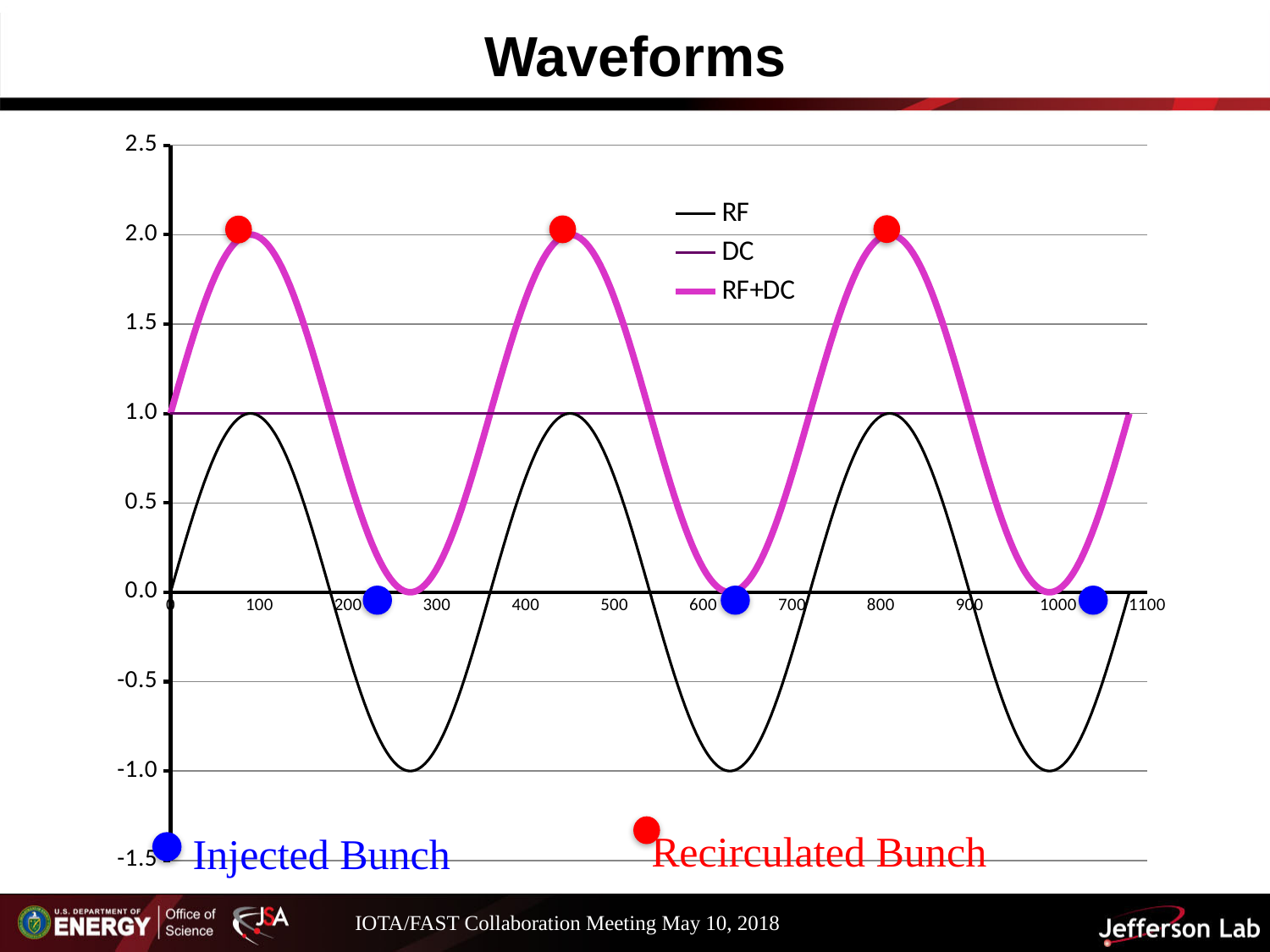
What is the lowest value reached by the RF series? -1.0 What is the peak value reached by the RF+DC series? 2.0 At x = 800, which series has the larger value, RF or RF+DC? RF+DC What kind of chart is shown on the slide? line chart What are the series names listed in the legend? RF, DC, RF+DC How many series does the legend list? 3 What constant value does the DC series hold across the x axis? 1.0 Which series reaches the highest value on the chart? RF+DC What is the title of the chart? Waveforms Which series reaches the lowest value on the chart? RF What is the peak value reached by the RF series? 1.0 Is the value of the RF+DC series at x = 800 greater or less than 1.5? greater